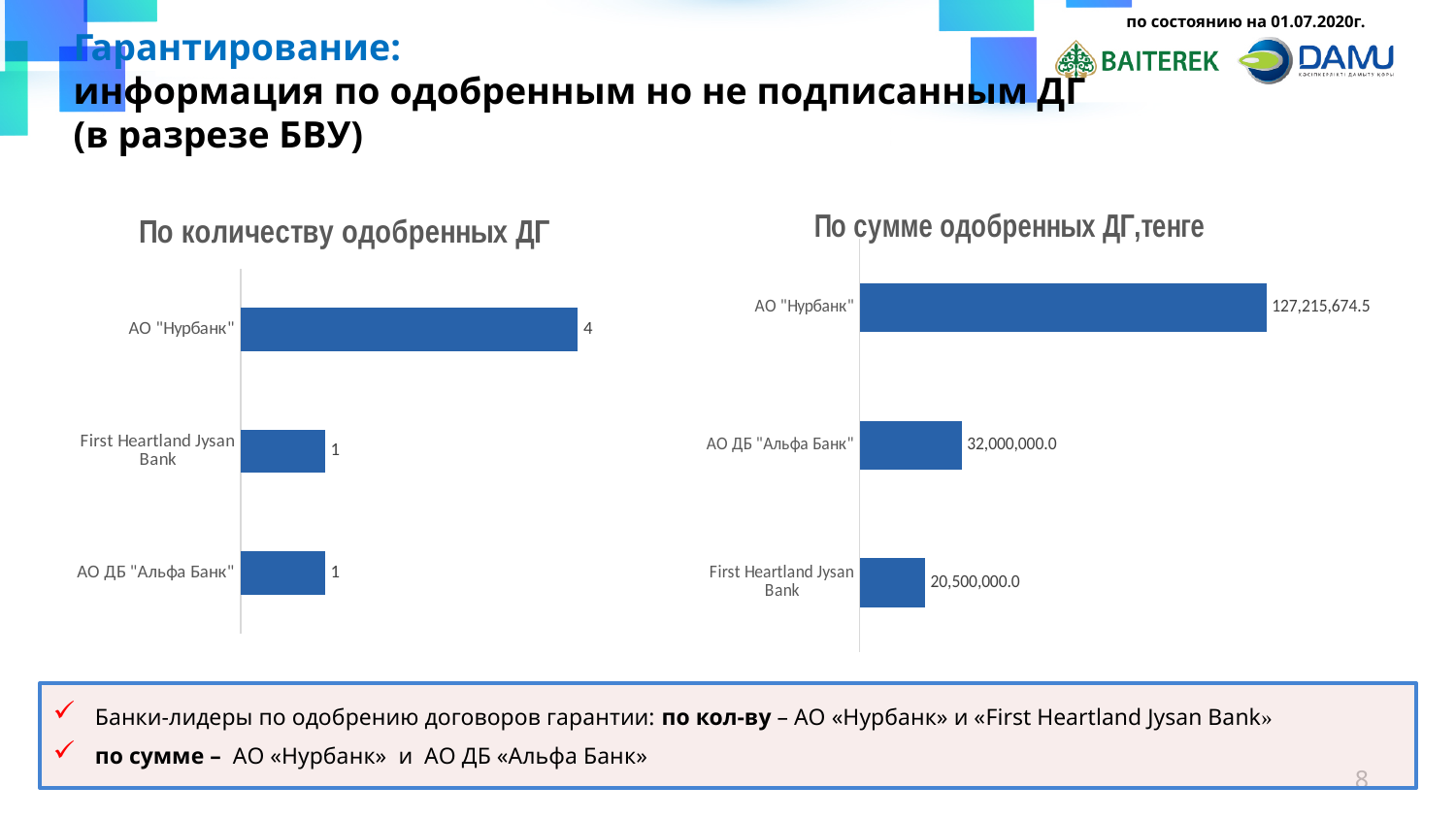
In the chart "По количеству одобренных ДГ", how many banks are shown? 3 In the chart "По сумме одобренных ДГ,тенге", what is the value for АО ДБ "Альфа Банк"? 32,000,000.0 In the chart "По количеству одобренных ДГ", what is the value for First Heartland Jysan Bank? 1 What type of chart is "По сумме одобренных ДГ,тенге"? Bar chart In the chart "По сумме одобренных ДГ,тенге", what is the value for First Heartland Jysan Bank? 20,500,000.0 In the chart "По сумме одобренных ДГ,тенге", what is the value for АО "Нурбанк"? 127,215,674.5 In the chart "По количеству одобренных ДГ", which bank has the highest value? АО "Нурбанк" In the chart "По сумме одобренных ДГ,тенге", which bank has the lowest value? First Heartland Jysan Bank In the chart "По сумме одобренных ДГ,тенге", which is larger: the value for АО ДБ "Альфа Банк" or for First Heartland Jysan Bank? АО ДБ "Альфа Банк" In the chart "По количеству одобренных ДГ", what is the difference between the values for АО "Нурбанк" and АО ДБ "Альфа Банк"? 3 In the chart "По количеству одобренных ДГ", what is the value for АО "Нурбанк"? 4 In the chart "По сумме одобренных ДГ,тенге", what is the difference between the values for АО ДБ "Альфа Банк" and First Heartland Jysan Bank? 11,500,000.0